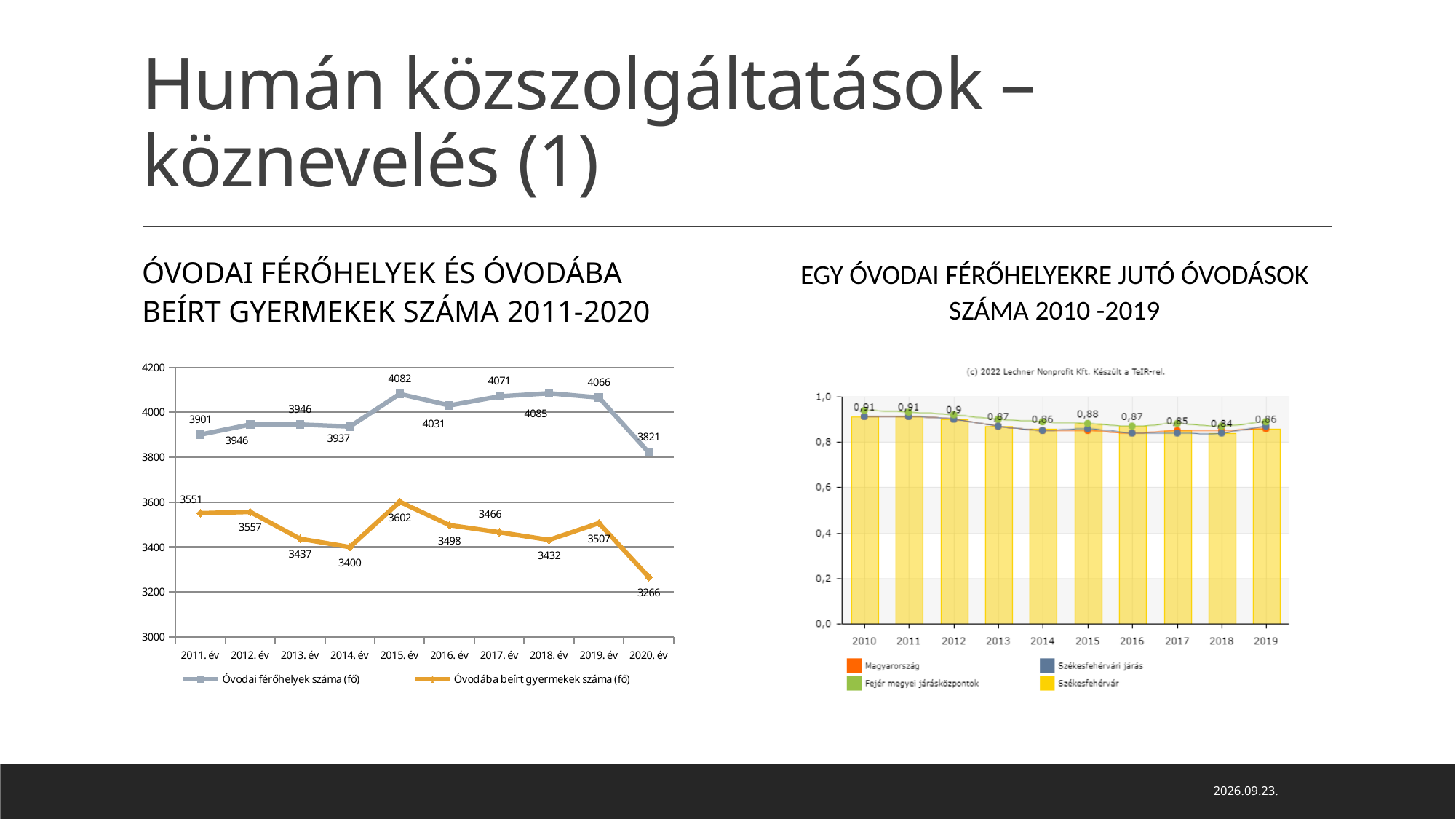
In the left chart, what is the difference between Óvodai férőhelyek száma (fő) and Óvodába beírt gyermekek száma (fő) in 2014. év? 537 In the left chart, how many series does the legend list? 2 In the left chart, which is larger: Óvodába beírt gyermekek száma (fő) in 2015. év or in 2019. év? 2015. év In the left chart, what is the value of Óvodába beírt gyermekek száma (fő) for 2020. év? 3266 In the right chart, is the Székesfehérvár value for 2018 greater or less than 0,6? greater In the left chart, how many years are shown on the x axis? 10 In the left chart (Óvodai férőhelyek és óvodába beírt gyermekek száma 2011-2020), what is the value of Óvodai férőhelyek száma (fő) for 2015. év? 4082 In the left chart, in which year is Óvodába beírt gyermekek száma (fő) lowest? 2020. év In the right chart (Egy óvodai férőhelyekre jutó óvodások száma 2010-2019), what is the value of the Székesfehérvár bar for 2010? 0,91 In the left chart, in which year is Óvodai férőhelyek száma (fő) highest? 2018. év In the right chart, how many series does the legend list? 4 What type of chart is the left chart? line chart